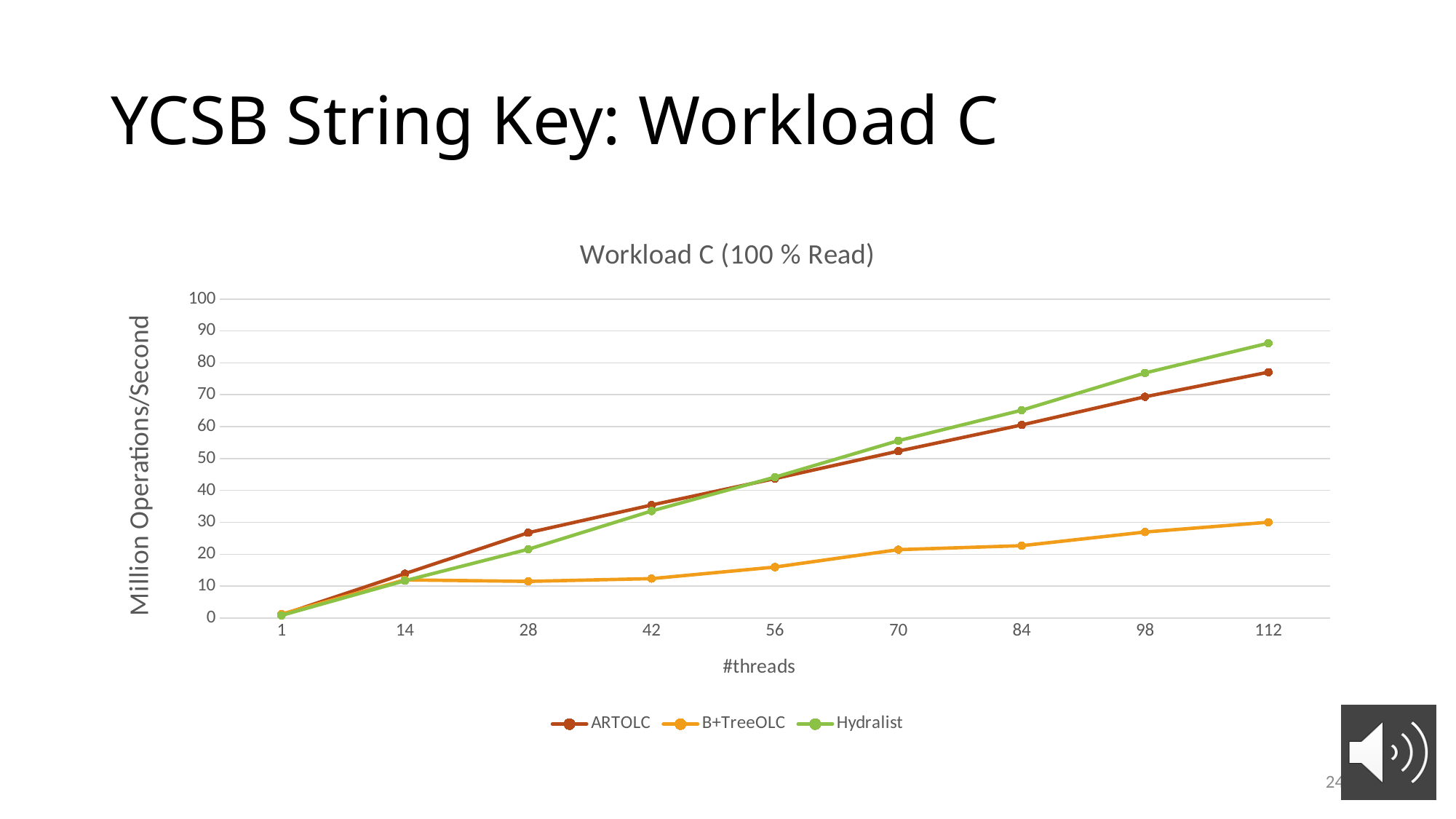
Is the value for B+TreeOLC at 112 threads greater or less than 40? less What kind of chart is shown on the slide? line chart What is the title of the chart? Workload C (100 % Read) What is the label of the y axis? Million Operations/Second How many series does the legend list? 3 Which series has the highest value at 112 threads? Hydralist Which series has the lowest value at 112 threads? B+TreeOLC Is the value for ARTOLC at 98 threads greater or less than 60? greater Does the B+TreeOLC series rise or fall overall as the number of threads increases? rises At 28 threads, which is larger: ARTOLC or Hydralist? ARTOLC Is the value for Hydralist at 112 threads greater or less than 80? greater How many thread counts are plotted along the x axis? 9